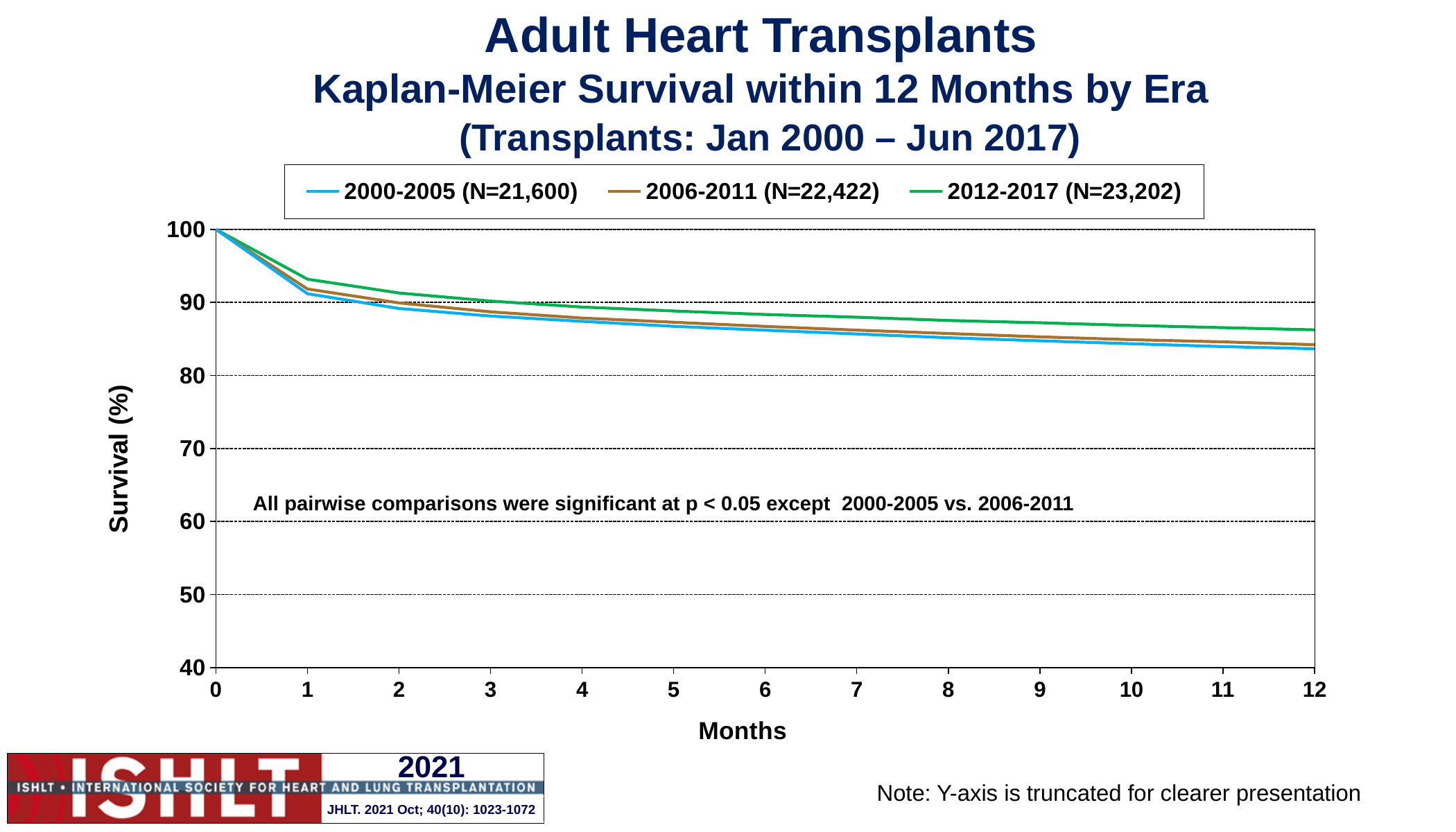
Do the survival curves rise or fall as months increase? Fall At 12 months, is survival for 2000-2005 greater or less than 90? less What is the N shown in the legend for the 2006-2011 era? N=22,422 What is the survival value for all three eras at month 0? 100 At 12 months, is survival for 2012-2017 greater or less than 80? greater What is the label of the y-axis? Survival (%) What type of chart is shown on the slide? Line chart Which era has the lowest survival at 12 months? 2000-2005 How many series (eras) does the legend list? 3 At month 1, is survival for 2012-2017 greater or less than 90? greater Which era has the highest survival at 12 months? 2012-2017 At 12 months, which is higher: survival for 2012-2017 or for 2000-2005? 2012-2017